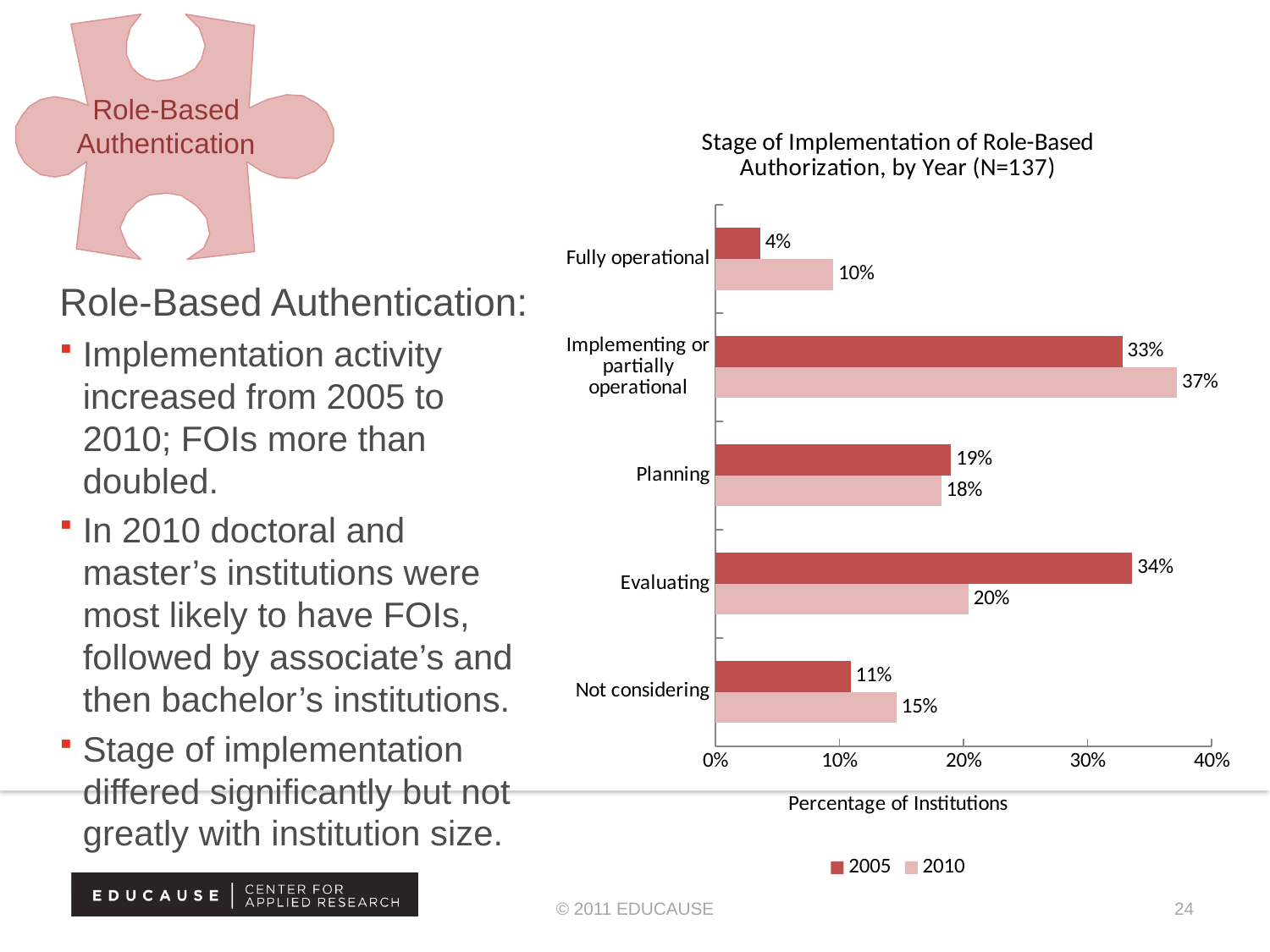
What is the value for Not considering in 2010? 15% How many stage categories are shown on the chart? 5 What is the difference between the 2010 and 2005 values for Evaluating? 14% What percentage of institutions were Fully operational in 2010? 10% How many series does the legend list? 2 What percentage of institutions were Evaluating in 2005? 34% Which stage has the lowest value for 2005? Fully operational What kind of chart is shown on the slide? Bar chart Which stage has the highest value for 2010? Implementing or partially operational Which is larger for Planning: the 2005 value or the 2010 value? 2005 What is the label of the x axis? Percentage of Institutions Is the 2010 value for Implementing or partially operational greater or less than 30%? greater